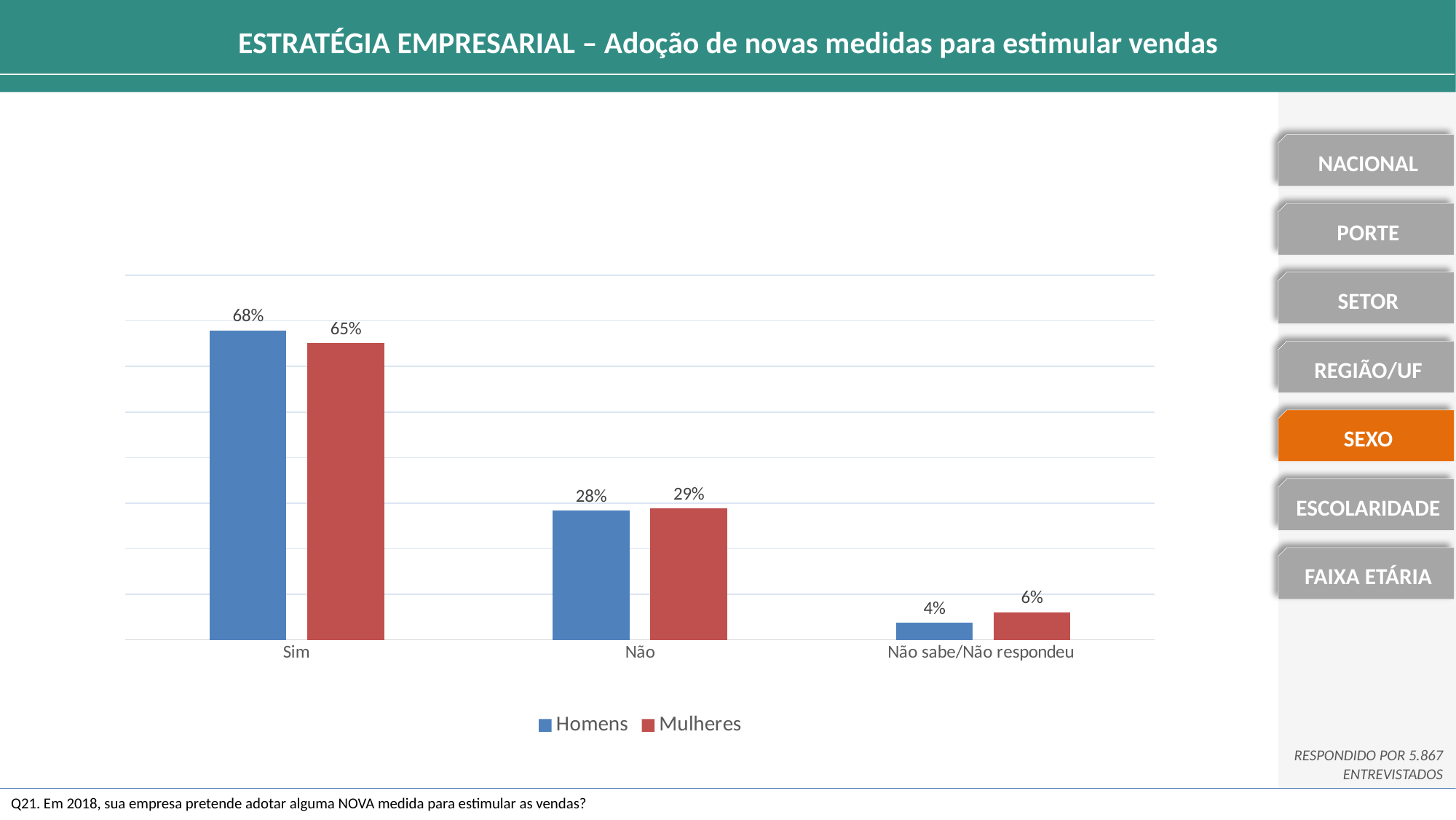
What is the difference between Mulheres and Homens in the Não sabe/Não respondeu category? 2% How many categories are shown on the x axis? 3 What is the value for Mulheres in the Não category? 29% What is the value for Mulheres in the Não sabe/Não respondeu category? 6% Which category has the highest value for Homens? Sim Which colour represents the Mulheres series in the legend? Red In the Sim category, which series has the larger value, Homens or Mulheres? Homens What is the value for Homens in the Sim category? 68% Which category has the lowest value for Mulheres? Não sabe/Não respondeu What kind of chart is shown on the slide? Bar chart What is the difference between Homens and Mulheres in the Sim category? 3% How many series does the legend list? 2